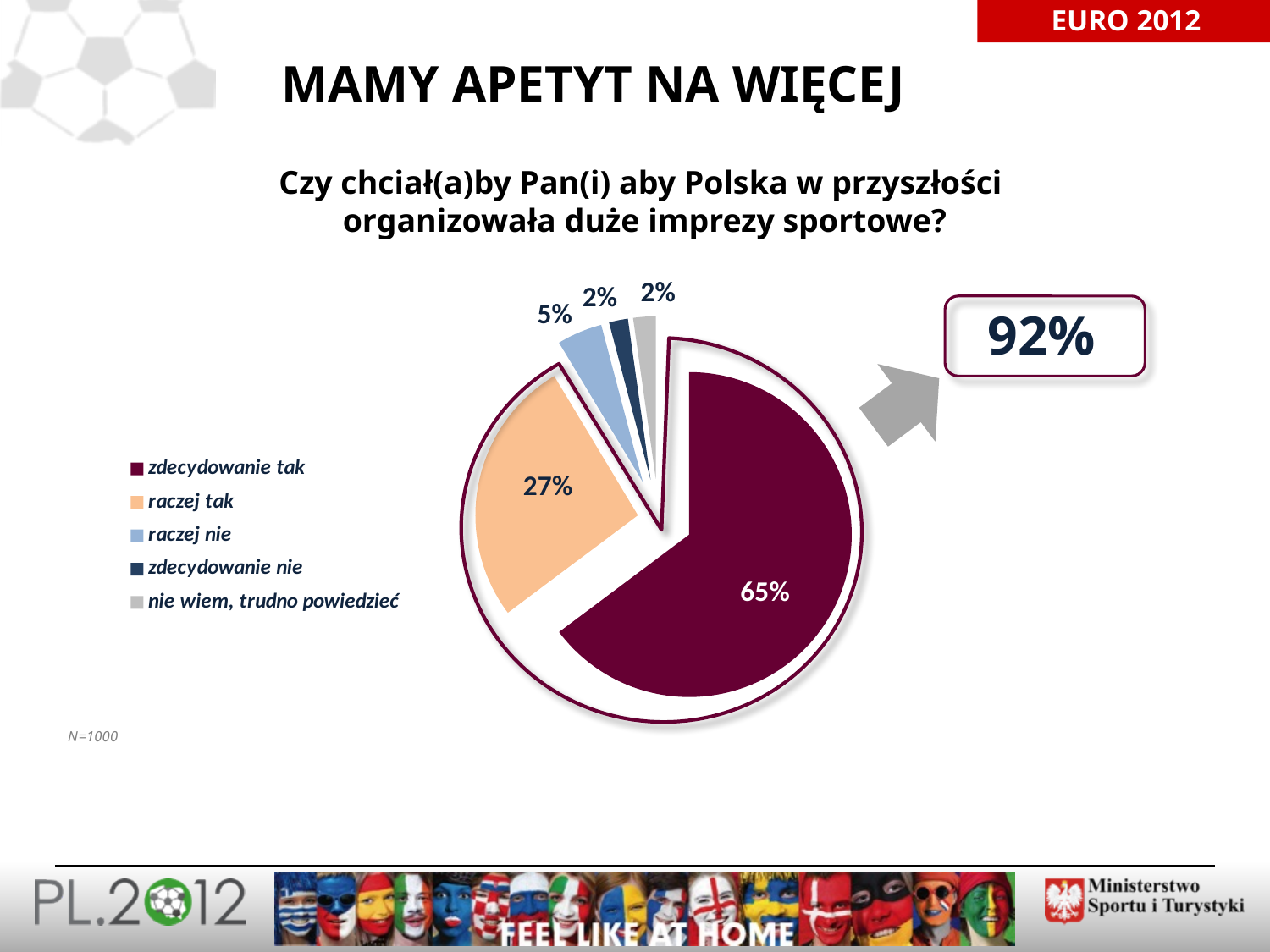
What type of chart is shown on the slide? pie chart What is the difference in percentage points between "zdecydowanie tak" and "raczej tak"? 38 What percentage of respondents answered "raczej tak"? 27% Which answer category has the largest share of the pie? zdecydowanie tak How many entries does the legend list? 5 What percentage of respondents answered "zdecydowanie nie"? 2% How many slices does the pie chart have? 5 Which is larger, the share for "raczej tak" or the share for "raczej nie"? raczej tak What is the combined share of "zdecydowanie tak" and "raczej tak"? 92% What percentage of respondents answered "zdecydowanie tak"? 65% What percentage of respondents answered "raczej nie"? 5% What value is shown in the callout box to the right of the pie chart? 92%